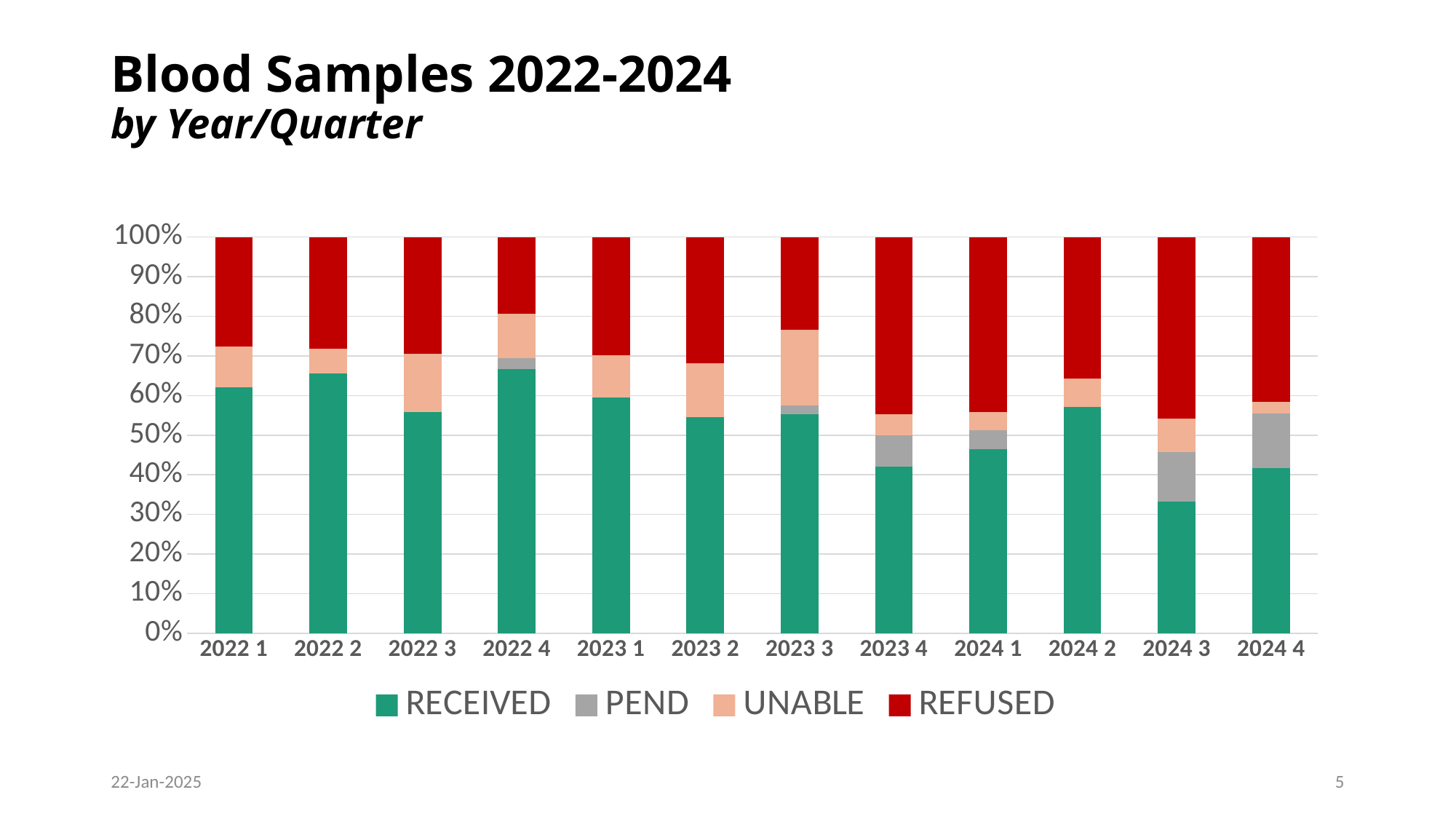
Is the RECEIVED share for 2022 4 greater or less than 60%? greater Which is larger, the REFUSED share for 2023 4 or for 2022 4? 2023 4 What is the title of the chart on the slide? Blood Samples 2022-2024 by Year/Quarter How many series does the legend list? 4 Which quarter has the lowest RECEIVED share? 2024 3 How many year/quarter categories are shown on the x axis? 12 Which is larger, the RECEIVED share for 2022 1 or for 2024 3? 2022 1 Is the RECEIVED share for 2022 2 greater or less than 60%? greater Which series is shown in red in the legend? REFUSED Is the RECEIVED share for 2024 3 greater or less than 40%? less What kind of chart is shown on the slide? Stacked bar chart